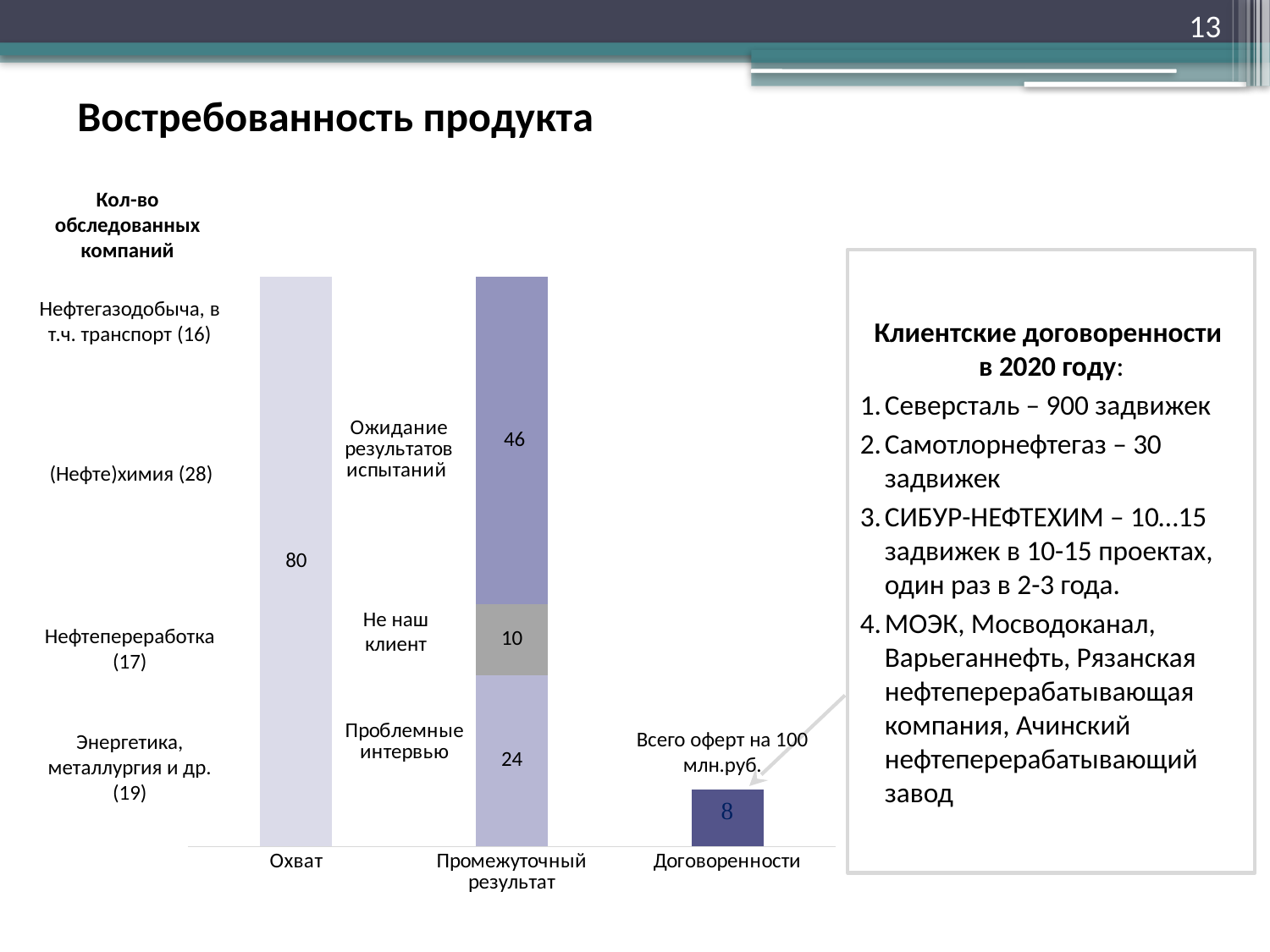
What is the value of the Договоренности bar? 8 In the Промежуточный результат bar, what is the value of the segment labelled Проблемные интервью? 24 What is the total of the stacked Промежуточный результат bar? 80 What is the difference between the Охват value and the Договоренности value? 72 Which category has the lowest value? Договоренности Which is larger: the Ожидание результатов испытаний segment or the Проблемные интервью segment? Ожидание результатов испытаний In the Промежуточный результат bar, what is the value of the segment labelled Не наш клиент? 10 How many categories are shown on the x axis? 3 What is the value of the Охват bar? 80 What is the title of the slide containing the chart? Востребованность продукта What kind of chart is shown on the slide? Stacked bar chart In the Промежуточный результат bar, what is the value of the segment labelled Ожидание результатов испытаний? 46